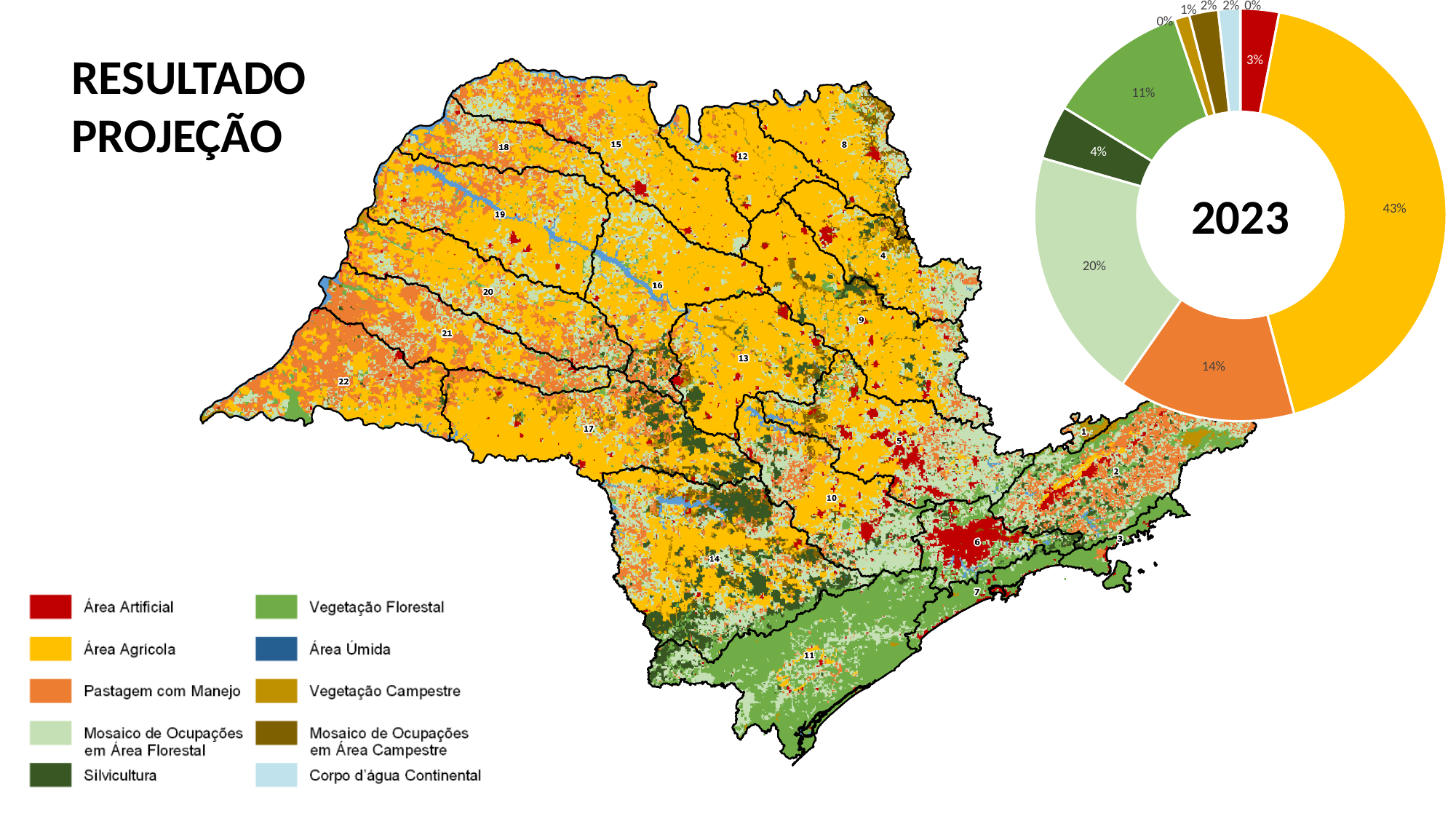
What percentage is shown for the dark green slice (Silvicultura) in the donut chart? 4% What is the largest share shown in the donut chart? 43% What percentage is shown for the light green slice (Mosaico de Ocupações em Área Florestal) in the donut chart? 20% In the donut chart, what is the difference between the yellow slice (43%) and the light green slice (20%)? 23% What percentage is shown for the red slice (Área Artificial) in the donut chart? 3% What year is printed in the centre of the donut chart? 2023 What percentage is shown for the medium green slice (Vegetação Florestal) in the donut chart? 11% In the donut chart, which is larger: the orange slice (Pastagem com Manejo) or the medium green slice (Vegetação Florestal)? Pastagem com Manejo (14%) How many slices does the donut chart have? 11 What percentage is shown for the orange slice (Pastagem com Manejo) in the donut chart? 14% What kind of chart is shown on the right side of the slide? Donut (pie) chart What percentage is shown for the yellow slice (Área Agrícola) in the donut chart? 43%